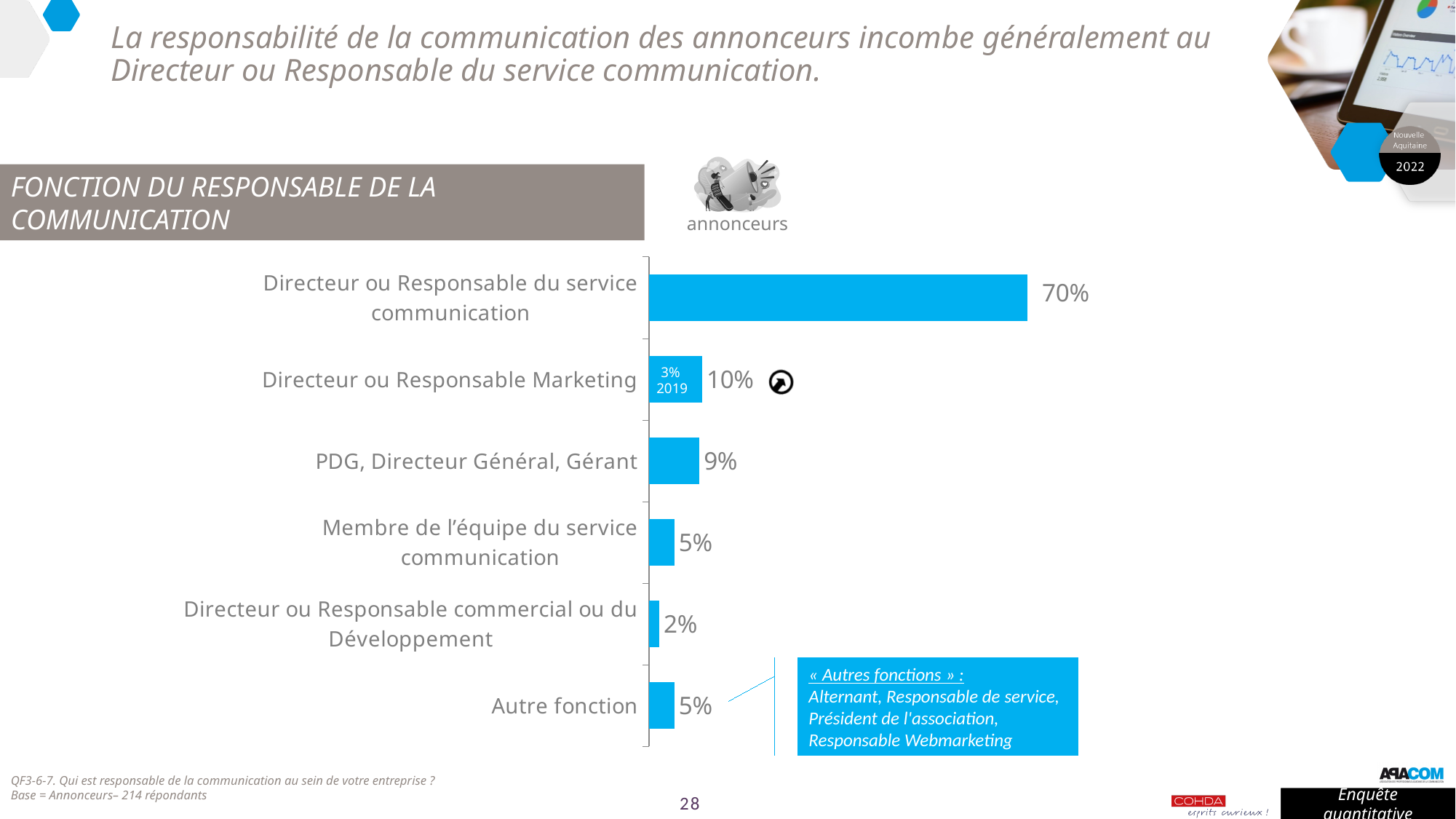
What is the difference between the values for "Directeur ou Responsable du service communication" and "Directeur ou Responsable Marketing"? 60 percentage points Which is larger: the value for "Directeur ou Responsable Marketing" or for "PDG, Directeur Général, Gérant"? Directeur ou Responsable Marketing What was the 2019 value noted for "Directeur ou Responsable Marketing"? 3% What percentage is shown for "Directeur ou Responsable Marketing"? 10% Which category has the highest value in the chart? Directeur ou Responsable du service communication What percentage is shown for "PDG, Directeur Général, Gérant"? 9% What percentage is shown for "Directeur ou Responsable du service communication"? 70% How many categories are shown in the chart? 6 What percentage is shown for "Autre fonction"? 5% What percentage is shown for "Directeur ou Responsable commercial ou du Développement"? 2% Which category has the lowest value in the chart? Directeur ou Responsable commercial ou du Développement What kind of chart is shown on the slide? Bar chart